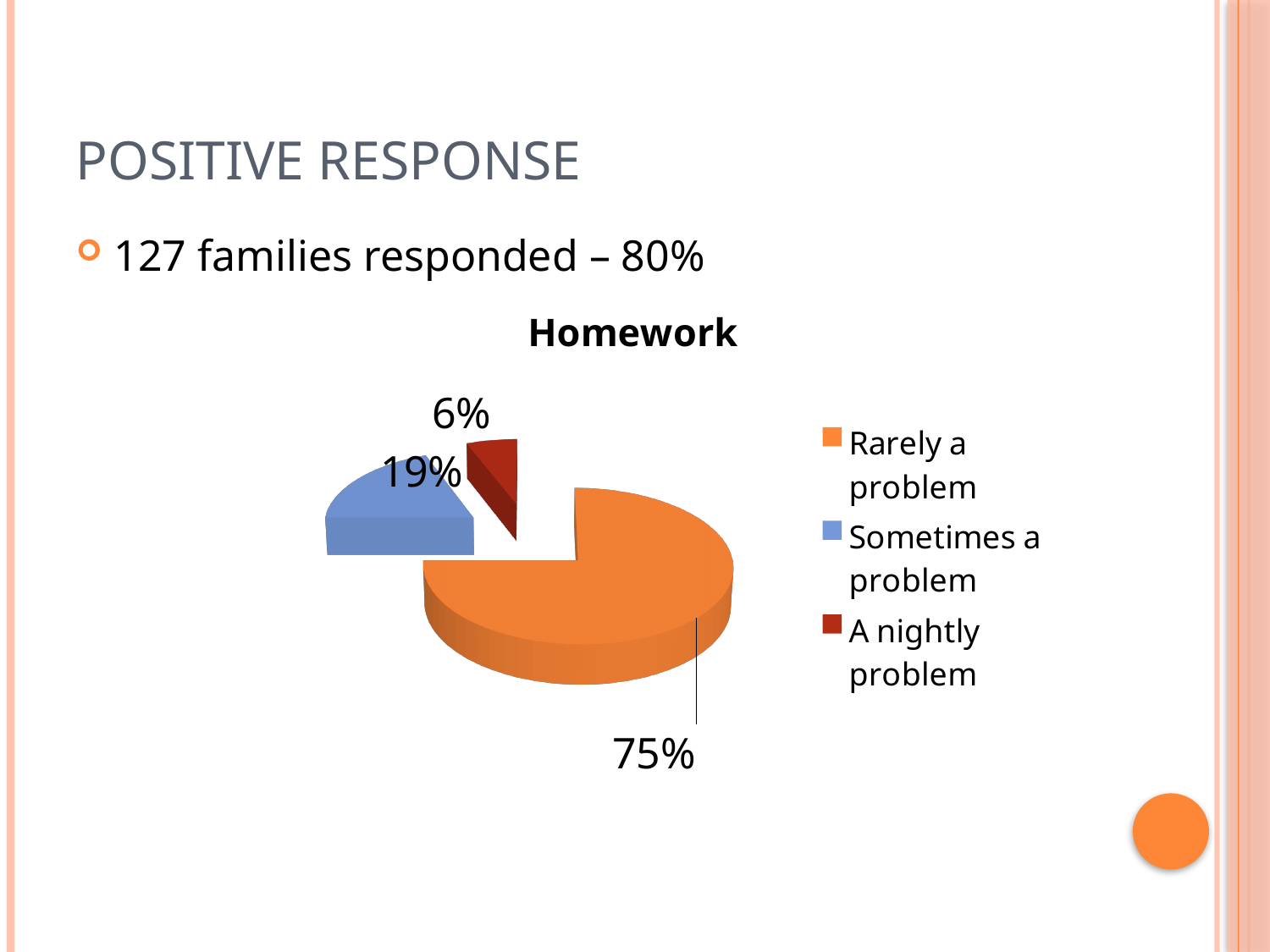
What share of the pie is 'Rarely a problem'? 75% What is the title of the chart? Homework Which is larger, the share for 'Sometimes a problem' or the share for 'A nightly problem'? Sometimes a problem What colour is the slice for 'Sometimes a problem'? blue What is the difference in percentage points between 'Sometimes a problem' and 'A nightly problem'? 13 What share of the pie is 'A nightly problem'? 6% What share of the pie is 'Sometimes a problem'? 19% Which category has the largest slice of the pie? Rarely a problem How many categories does the pie chart show? 3 What is the difference in percentage points between 'Rarely a problem' and 'Sometimes a problem'? 56 Which category has the smallest slice of the pie? A nightly problem What kind of chart is shown on the slide? pie chart